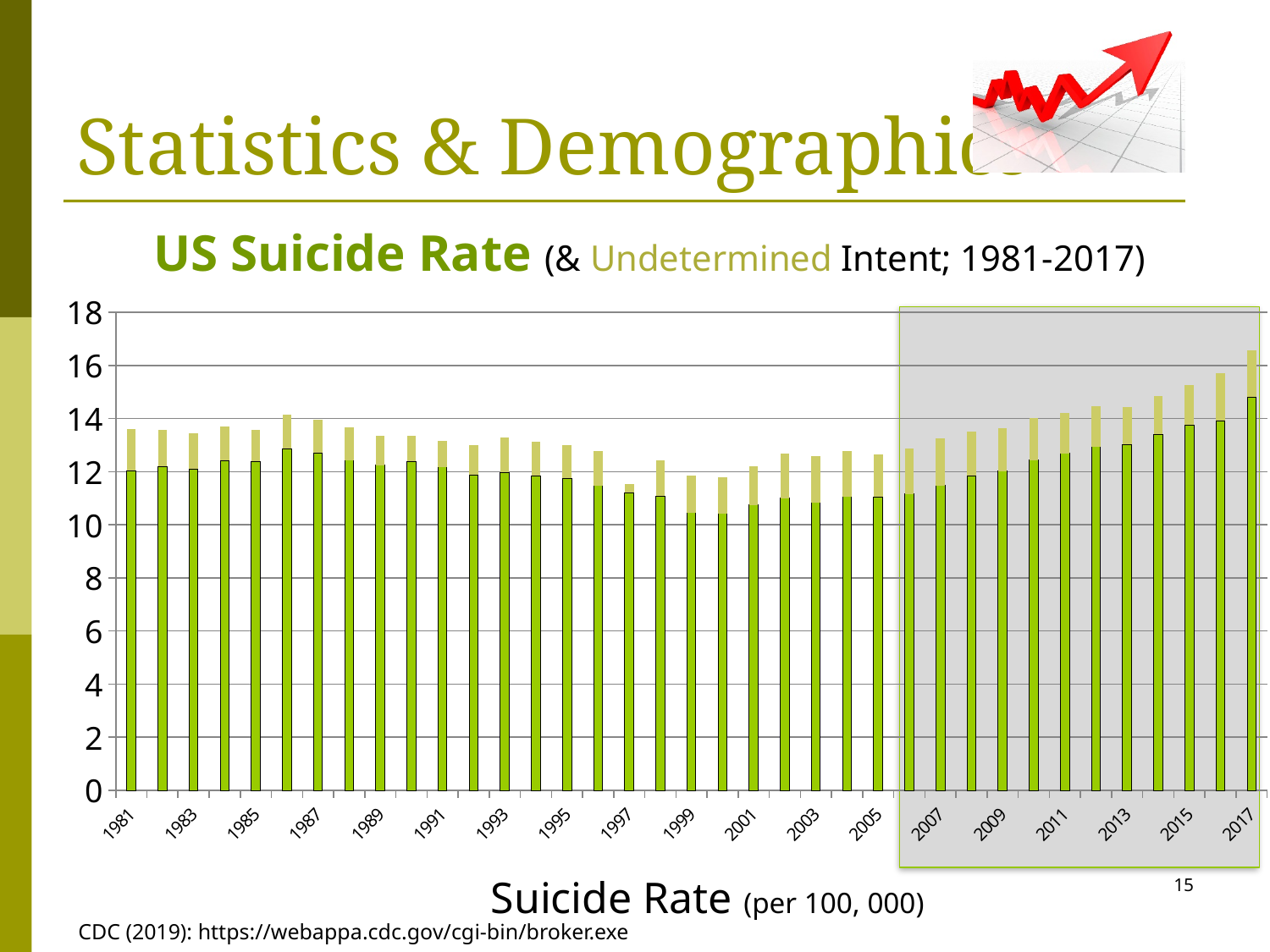
Is the total height of the 2017 bar greater or less than 16? greater Is the green (suicide rate) value for 2017 greater or less than 14? greater What is the label shown beneath the x axis of the chart? Suicide Rate (per 100, 000) How many stacked segments (series) does each bar in the chart have? 2 Is the green (suicide rate) value for 1997 greater or less than 12? less Which year has the larger green (suicide rate) value, 1981 or 2017? 2017 Which year has the tallest total bar in the chart? 2017 What is the title of the chart? US Suicide Rate (& Undetermined Intent; 1981-2017) Do the bar values rise or fall from 2007 to 2017? rise How many year labels are printed along the x axis? 19 What kind of chart is shown on the slide? bar chart